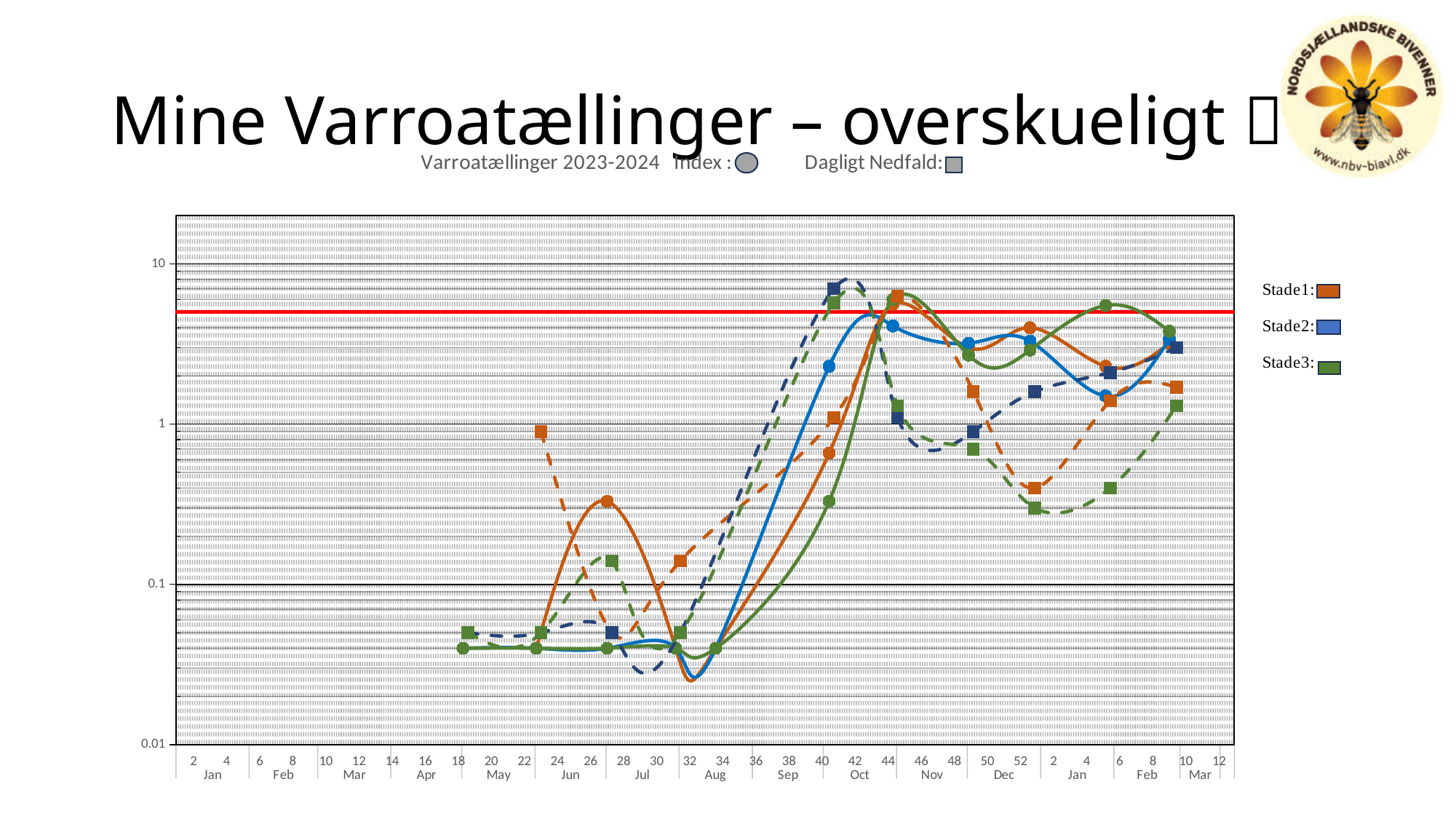
Is the Stade1 Dagligt Nedfald value at week 52 (Dec) greater or less than 1? less Is the Stade3 Index value at week 18 (May) greater or less than 0.1? less How many series does the legend on the right of the chart list? 3 At week 6 (Feb), which series has the highest Index value? Stade3 Is the Stade2 Index value at week 6 (Feb) greater or less than 1? greater What kind of chart is shown on the slide? line chart Does the Stade3 Index value rise or fall from week 32 (Aug) to week 44 (Oct)? rise What is the title of the chart? Varroatællinger 2023-2024 Which marker shape represents the Index series in the chart? circle At week 40 (Oct), which has the higher Index value, Stade1 or Stade2? Stade2